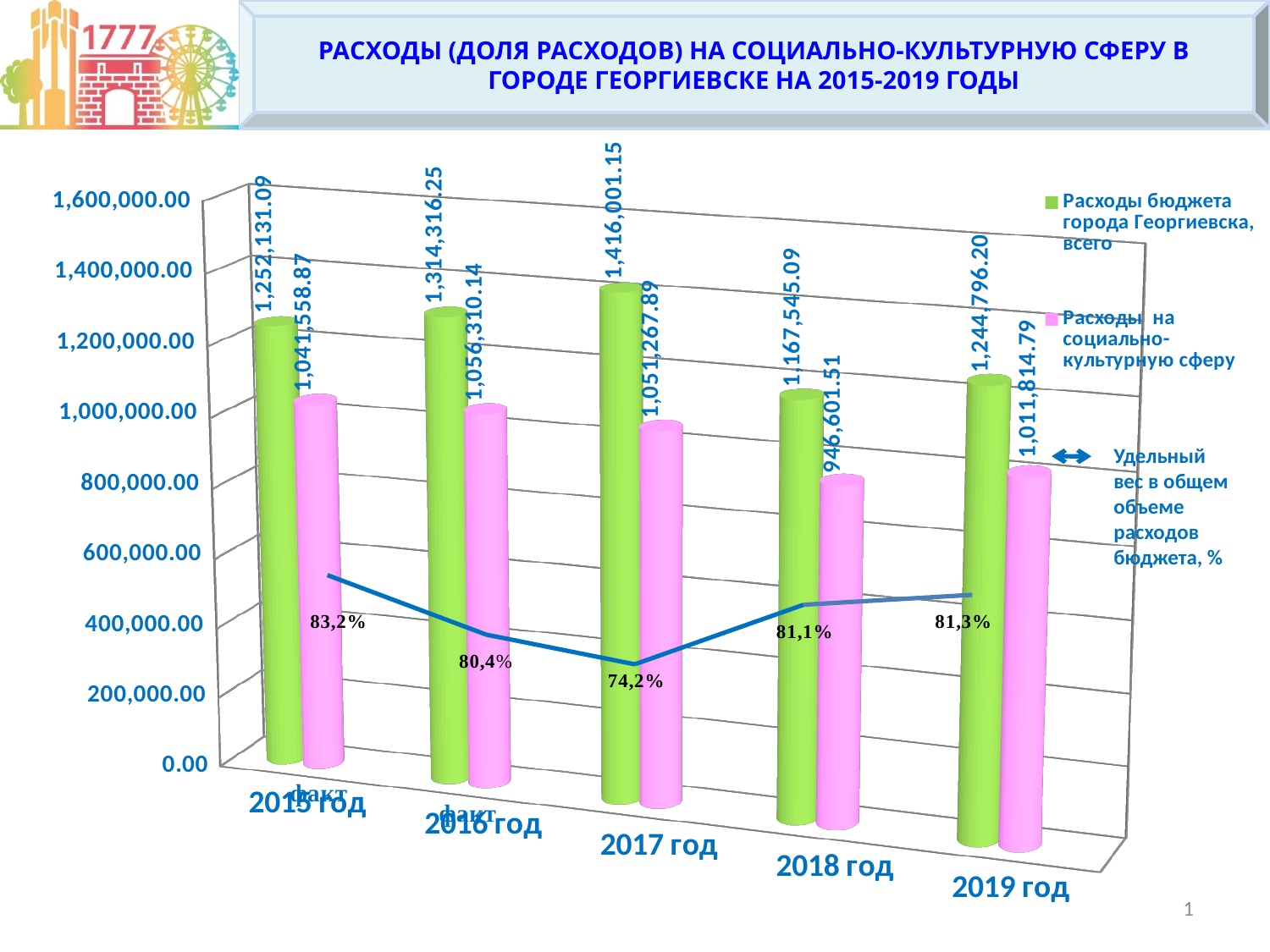
What is the 'Удельный вес в общем объеме расходов бюджета, %' value for 2015 год? 83,2% Which is larger: 'Расходы на социально-культурную сферу' in 2016 год or in 2019 год? 2016 год What is the value of 'Расходы на социально-культурную сферу' for 2018 год? 946,601.51 In which year is the 'Удельный вес в общем объеме расходов бюджета, %' the lowest? 2017 год In which year is 'Расходы бюджета города Георгиевска, всего' the highest? 2017 год How many series does the legend list? 3 What is the difference between 'Расходы бюджета города Георгиевска, всего' and 'Расходы на социально-культурную сферу' in 2017 год? 364,733.26 What is the value of 'Расходы на социально-культурную сферу' for 2019 год? 1,011,814.79 In which year is 'Расходы бюджета города Георгиевска, всего' the lowest? 2018 год How many years are shown on the x axis? 5 Does the 'Удельный вес в общем объеме расходов бюджета, %' line rise or fall from 2015 год to 2017 год? fall What is the value of 'Расходы бюджета города Георгиевска, всего' for 2017 год? 1,416,001.15